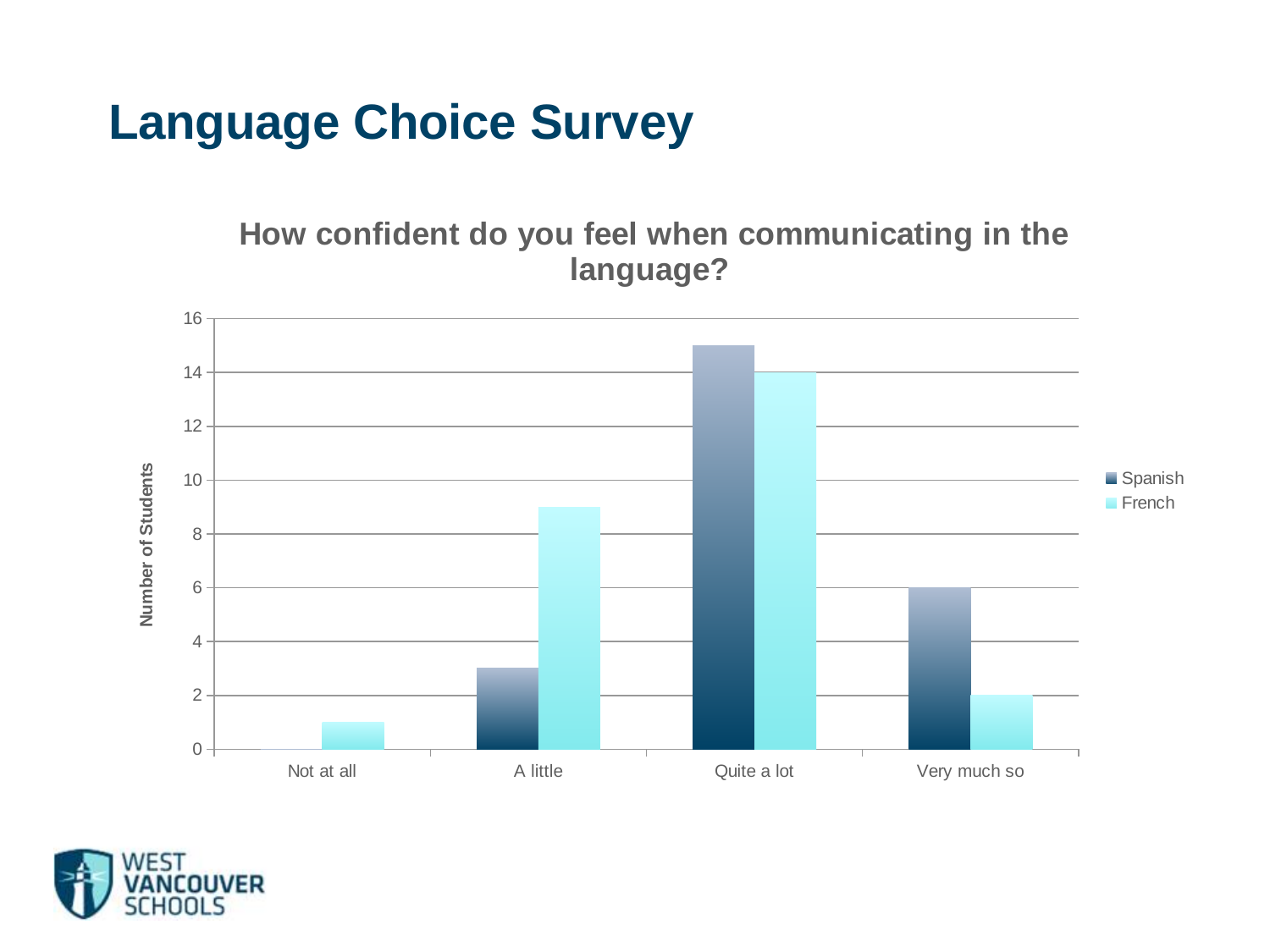
Which category has the lowest value for French? Not at all What is the difference between the Spanish and French values in the 'Very much so' category? 4 What kind of chart is shown on the slide? bar chart Which category has the highest value for Spanish? Quite a lot In the 'A little' category, which series has the larger value, Spanish or French? French What is the number of students for Spanish in the 'Very much so' category? 6 Is the value for French in the 'A little' category greater or less than 8? greater What is the number of students for French in the 'Quite a lot' category? 14 What is the number of students for French in the 'Very much so' category? 2 How many categories are shown on the x axis? 4 What is the label of the y axis? Number of Students How many series does the legend list? 2